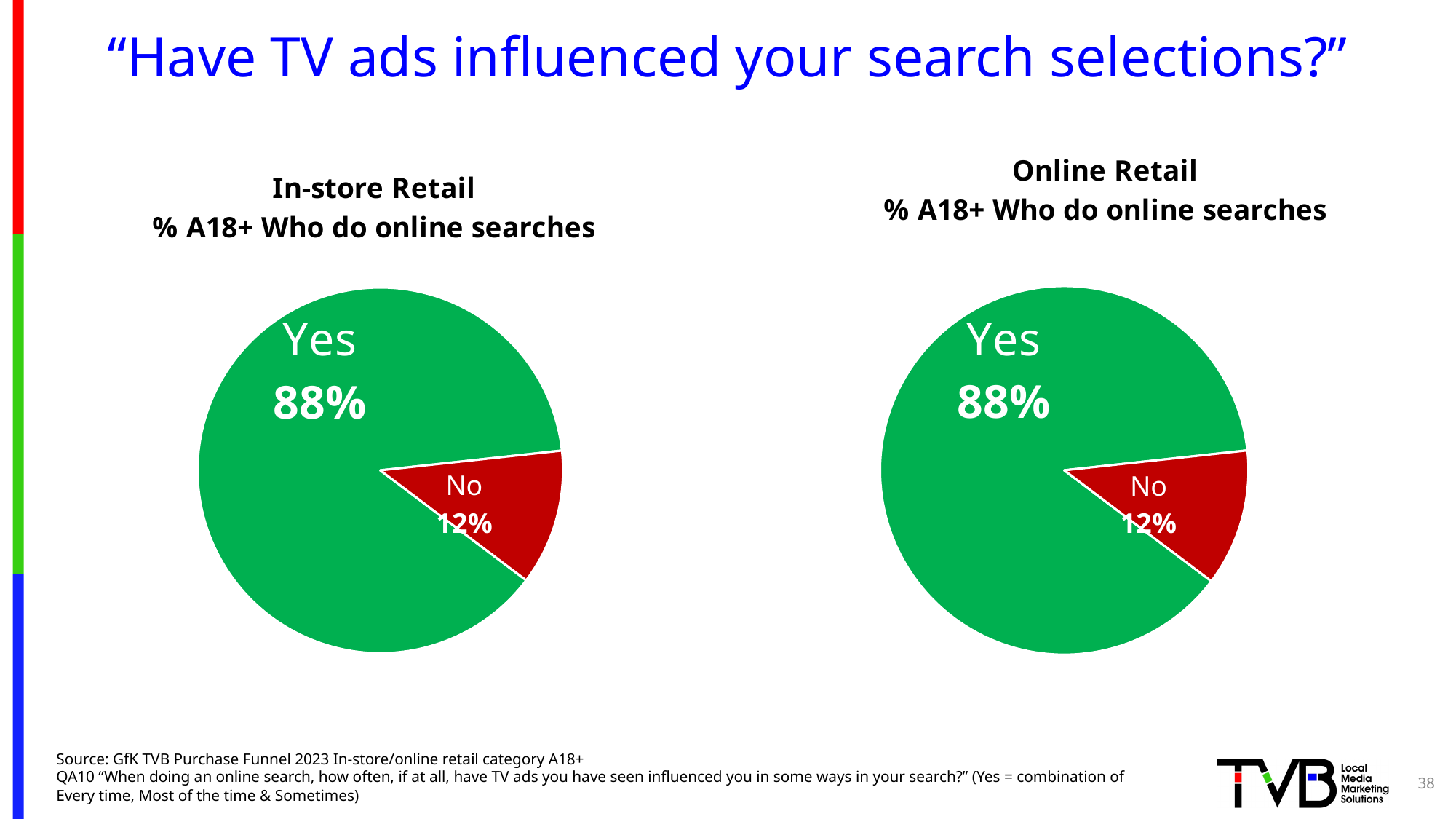
In the In-store Retail chart, which slice is the largest? Yes In the In-store Retail chart, what percentage answered Yes? 88% In the Online Retail chart, is the Yes slice larger or smaller than the No slice? larger In the Online Retail chart, what percentage answered No? 12% In the Online Retail chart, what colour is the No slice? red In the In-store Retail chart, what percentage answered No? 12% In the In-store Retail chart, what colour is the Yes slice? green What kind of chart is the In-store Retail chart? pie chart In the Online Retail chart, what percentage answered Yes? 88% How many slices does the Online Retail pie chart have? 2 In the In-store Retail chart, what is the difference between the Yes and No percentages? 76% In the Online Retail chart, which slice is the smallest? No